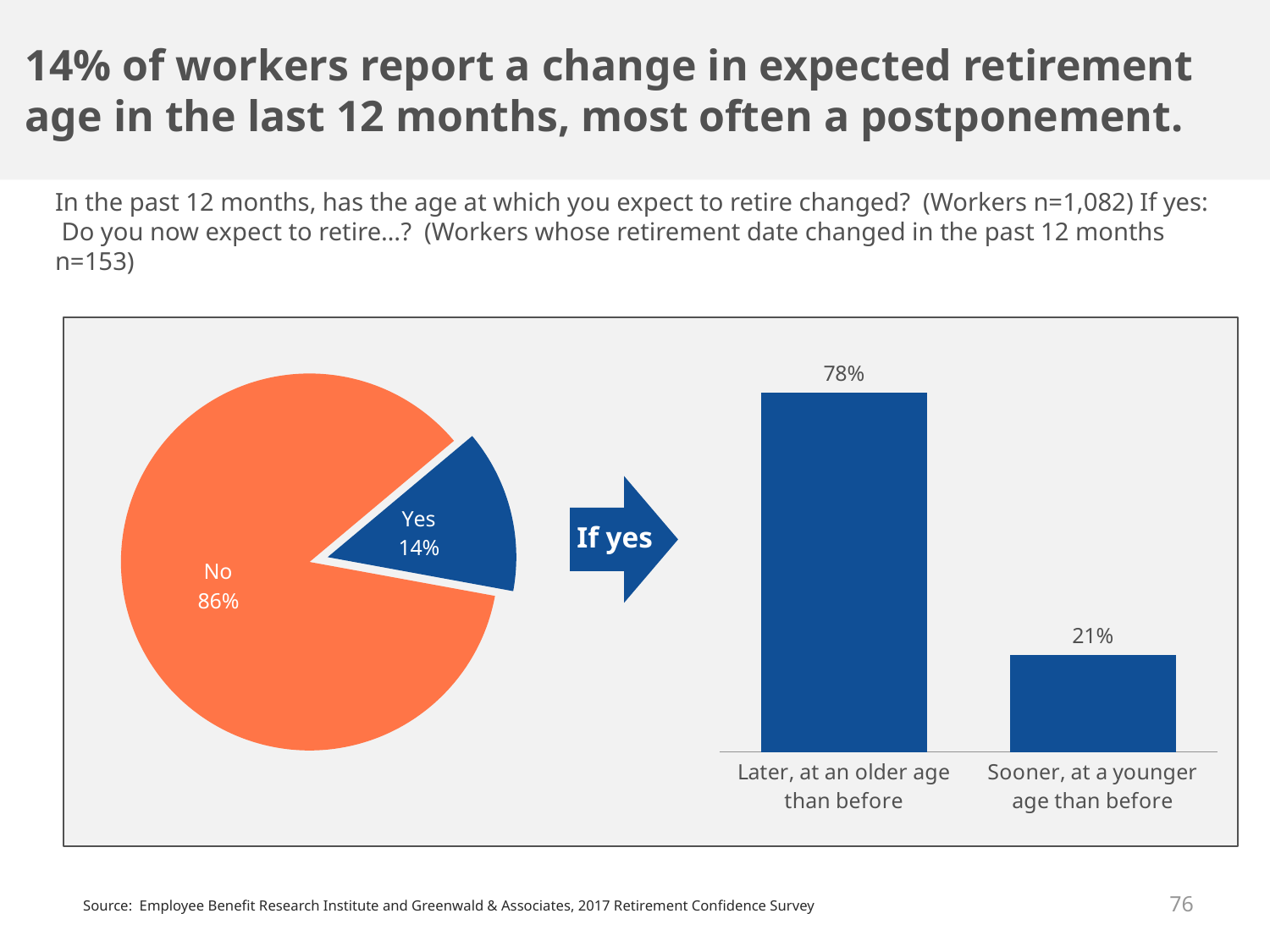
In the bar chart on the right, what is the difference between the two bars? 57% In the pie chart on the left, what percentage of workers answered "Yes"? 14% What colour is the "No" slice in the pie chart on the left? Orange What kind of chart is on the right side of the slide? Bar chart In the bar chart on the right, which category has the lowest value? Sooner, at a younger age than before In the pie chart on the left, what percentage of workers answered "No"? 86% In the pie chart on the left, what is the difference between the "No" and "Yes" shares? 72% In the pie chart on the left, which slice is the largest? No In the bar chart on the right, what is the value for "Sooner, at a younger age than before"? 21% In the bar chart on the right, how many bars are there? 2 In the pie chart on the left, how many slices are there? 2 In the bar chart on the right, what is the value for "Later, at an older age than before"? 78%